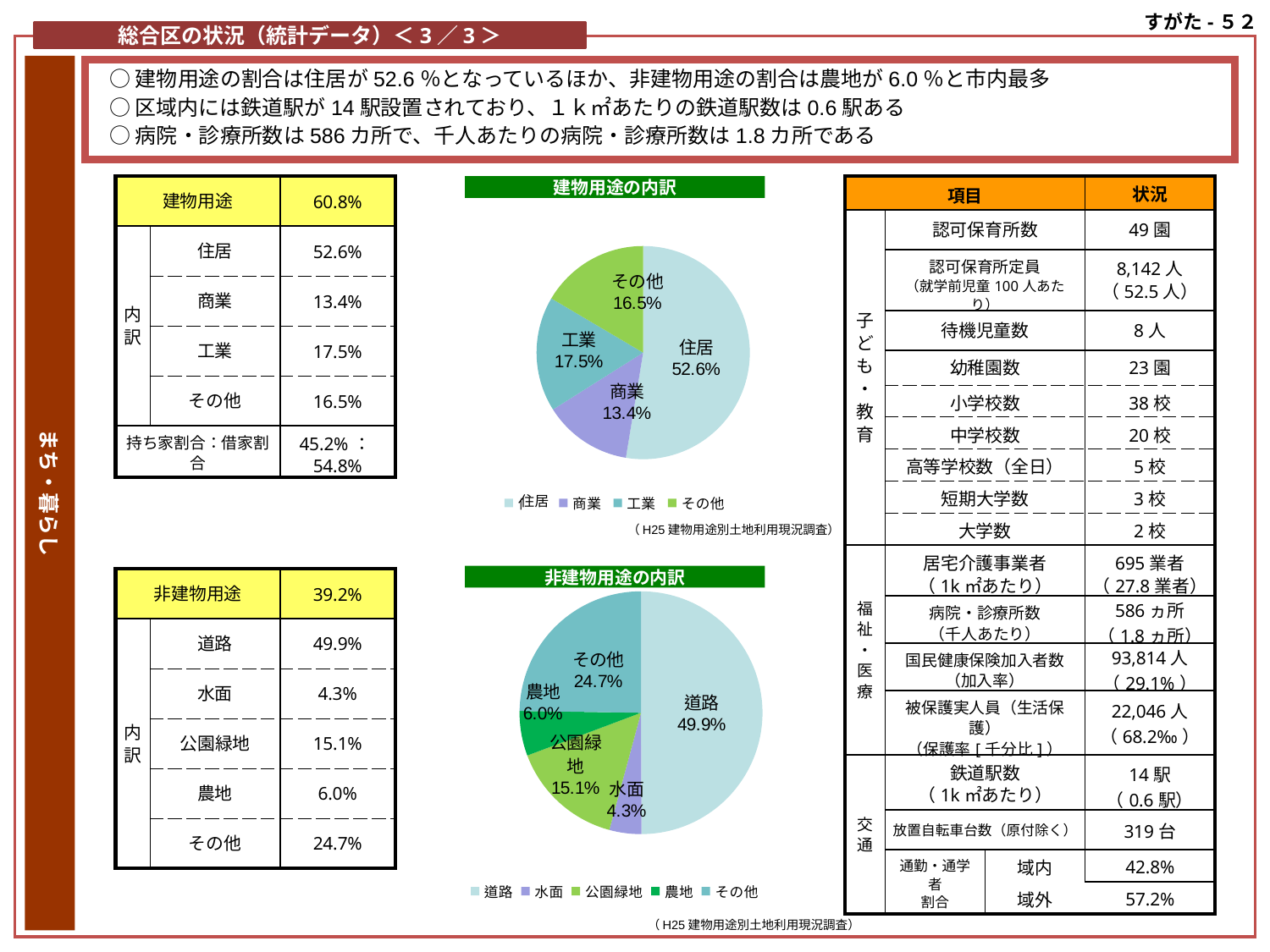
In the 建物用途の内訳 pie chart, how many slices are there? 4 In the 非建物用途の内訳 pie chart, what is the share for 農地? 6.0% In the 建物用途の内訳 pie chart, what is the share for 工業? 17.5% In the 建物用途の内訳 pie chart, which category has the smallest share? 商業 In the 非建物用途の内訳 pie chart, what is the share for 道路? 49.9% In the 非建物用途の内訳 pie chart, what is the difference between the shares of 公園緑地 and 水面? 10.8% In the 非建物用途の内訳 pie chart, which is larger, 公園緑地 or その他? その他 How many entries does the legend of the 非建物用途の内訳 pie chart list? 5 What type of chart is the 建物用途の内訳 chart? pie chart In the 建物用途の内訳 pie chart, what is the share for 住居? 52.6% In the 建物用途の内訳 pie chart, what is the difference between the shares of 工業 and その他? 1.0% In the 非建物用途の内訳 pie chart, which category has the smallest share? 水面